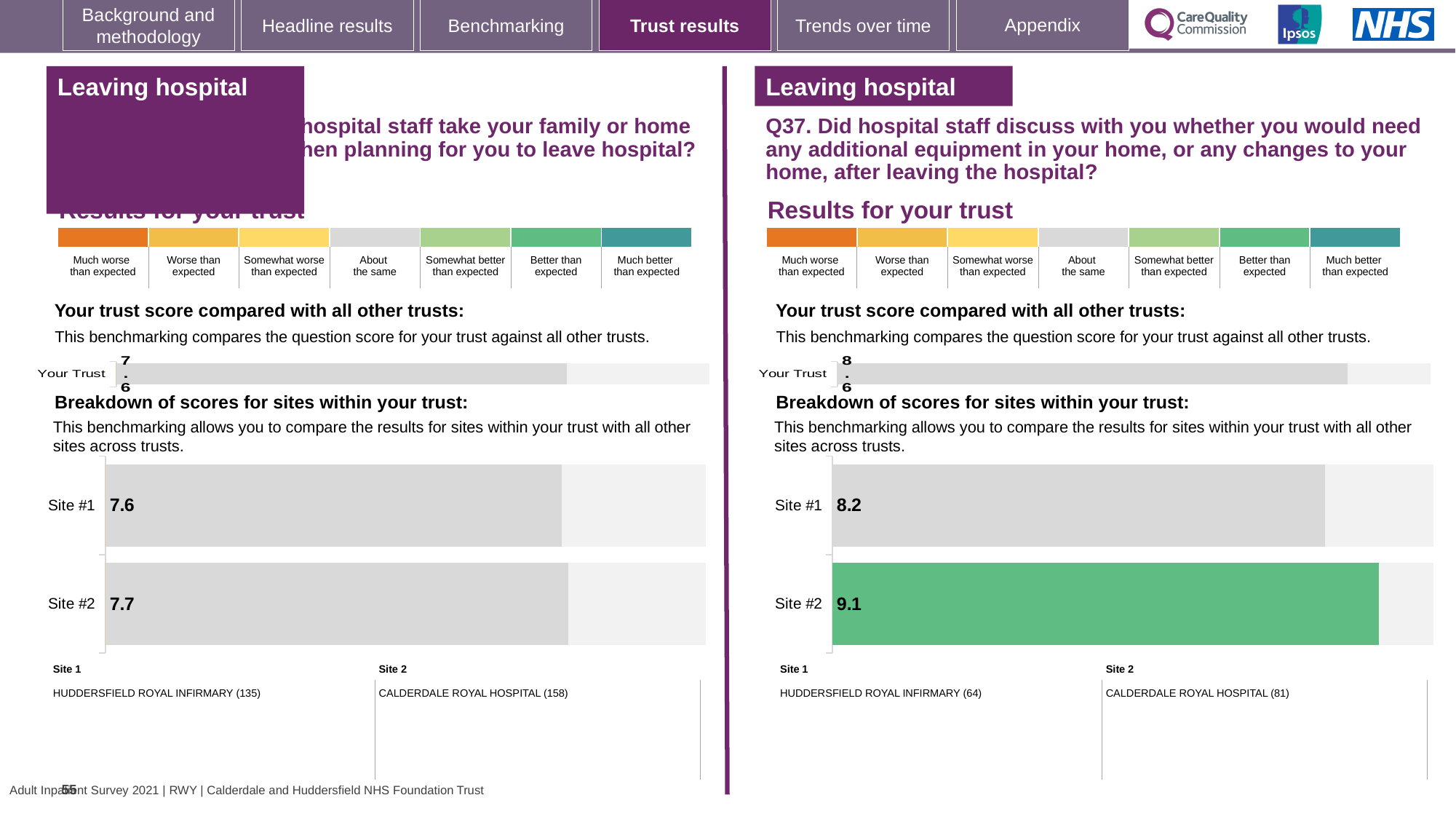
On the right-hand chart (Q37), how many sites are shown in the breakdown? 2 On the right-hand chart (Q37), what is the score for Site #2? 9.1 On the right-hand chart (Q37), what is the difference between the Site #2 and Site #1 scores? 0.9 On the right-hand chart (Q37), what is the score for Site #1? 8.2 On the right-hand chart (Q37), which site's bar is coloured green? Site #2 On the left-hand chart, what is the score for Site #2? 7.7 On the left-hand chart, what is the difference between the Site #2 and Site #1 scores? 0.1 What type of chart is used to show the breakdown of scores for sites on the right-hand panel? Bar chart On the right-hand chart (Q37), which site has the higher score? Site #2 On the left-hand chart, what is the 'Your Trust' score? 7.6 On the right-hand chart (Q37), what is the 'Your Trust' score? 8.6 On the left-hand chart, what is the score for Site #1? 7.6